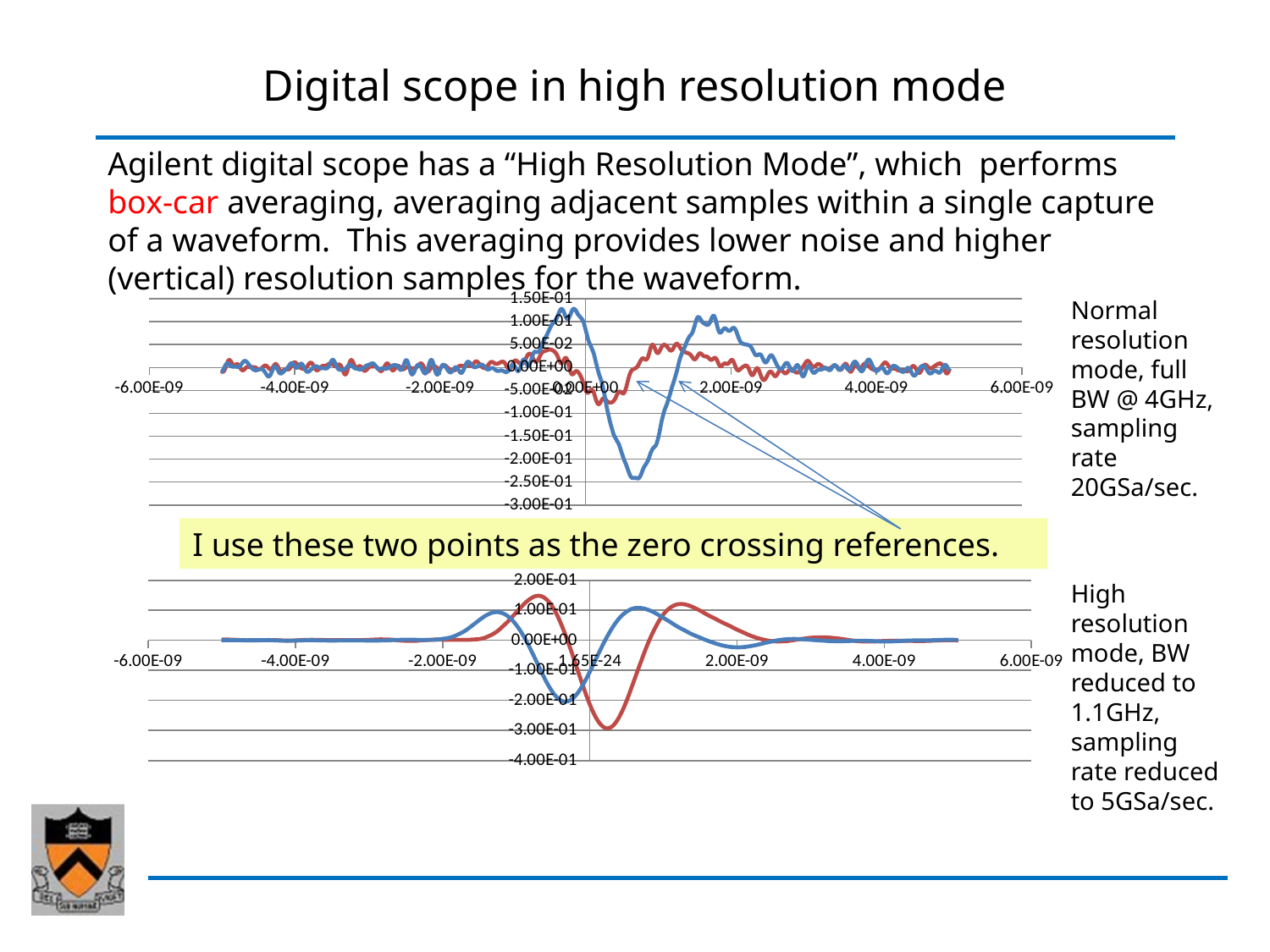
What kind of chart is the top chart on the slide? line chart In the top chart, which line reaches the lower minimum value, the blue line or the red line? blue line In the bottom chart, is the lowest value of the blue line greater or less than -3.00E-01? greater How many charts are shown on the slide? 2 In the bottom chart, which line reaches the lower minimum value, the blue line or the red line? red line In the top chart, is the red line's lowest value greater or less than -1.50E-01? greater In the top chart, is the lowest value of the blue line greater or less than -2.00E-01? less What is the highest tick value shown on the vertical axis of the top chart? 1.50E-01 What is the lowest tick value shown on the vertical axis of the bottom chart? -4.00E-01